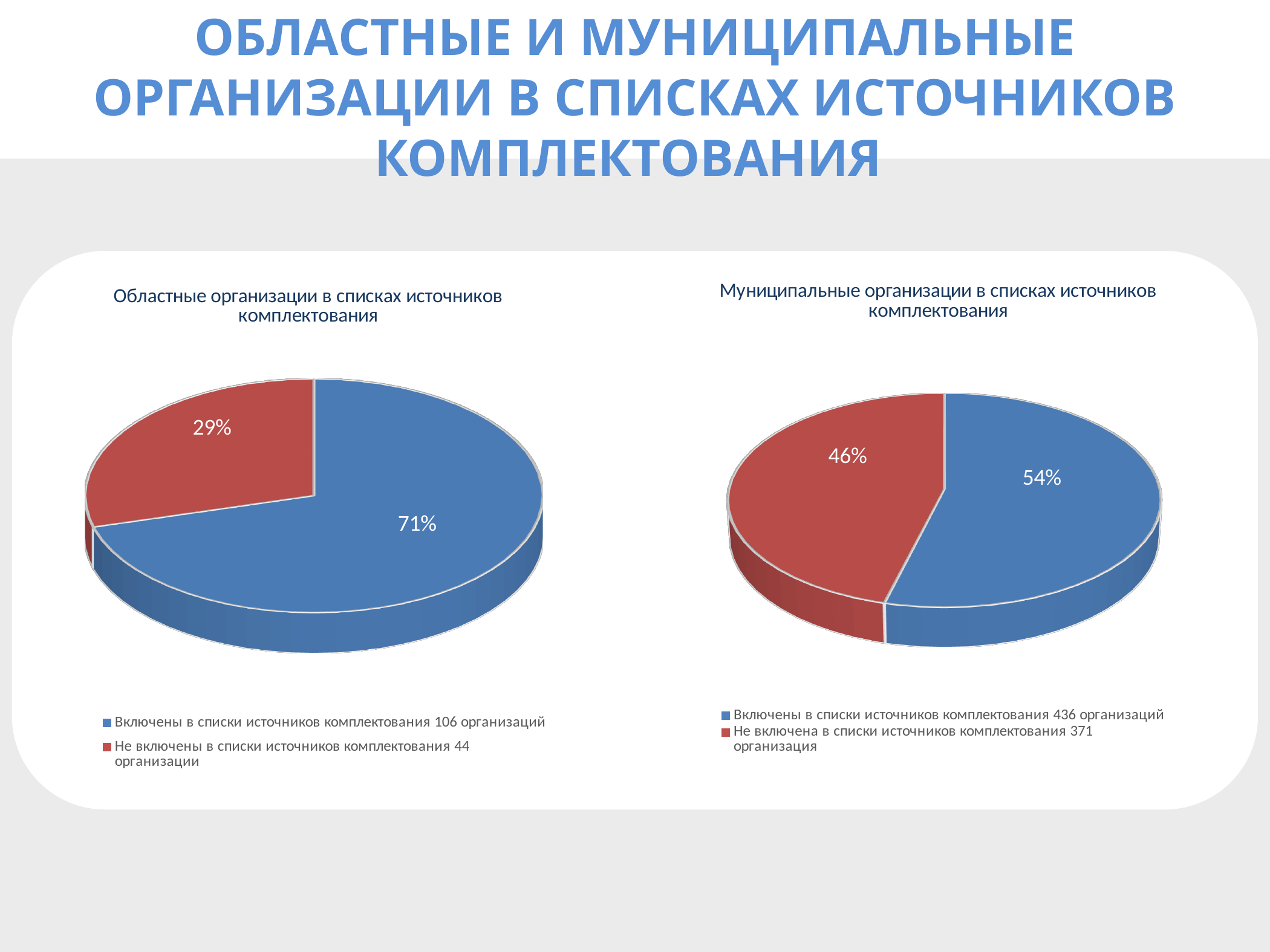
In the right chart (Муниципальные организации в списках источников комплектования), what percentage is shown for the blue slice 'Включены в списки источников комплектования 436 организаций'? 54% In the right chart (Муниципальные организации), which slice is the smallest? Не включена в списки источников комплектования 371 организация In the right chart (Муниципальные организации в списках источников комплектования), what percentage is shown for the red slice 'Не включена в списки источников комплектования 371 организация'? 46% What type of chart is used for the left chart (Областные организации в списках источников комплектования)? Pie chart In the left chart (Областные организации в списках источников комплектования), what percentage is shown for the red slice 'Не включены в списки источников комплектования 44 организации'? 29% Which is larger: the 'Включены' share in the left chart (Областные организации) or the 'Включены' share in the right chart (Муниципальные организации)? Left chart (Областные организации), 71% In the right chart (Муниципальные организации), what is the difference in percentage points between the 'Включены' slice and the 'Не включена' slice? 8 How many slices does the right chart (Муниципальные организации в списках источников комплектования) have? 2 In the left chart (Областные организации), what is the difference in percentage points between the 'Включены' slice and the 'Не включены' slice? 42 In the left chart (Областные организации), which slice is the largest? Включены в списки источников комплектования 106 организаций How many entries does the legend of the left chart (Областные организации) list? 2 In the left chart (Областные организации в списках источников комплектования), what percentage is shown for the blue slice 'Включены в списки источников комплектования 106 организаций'? 71%